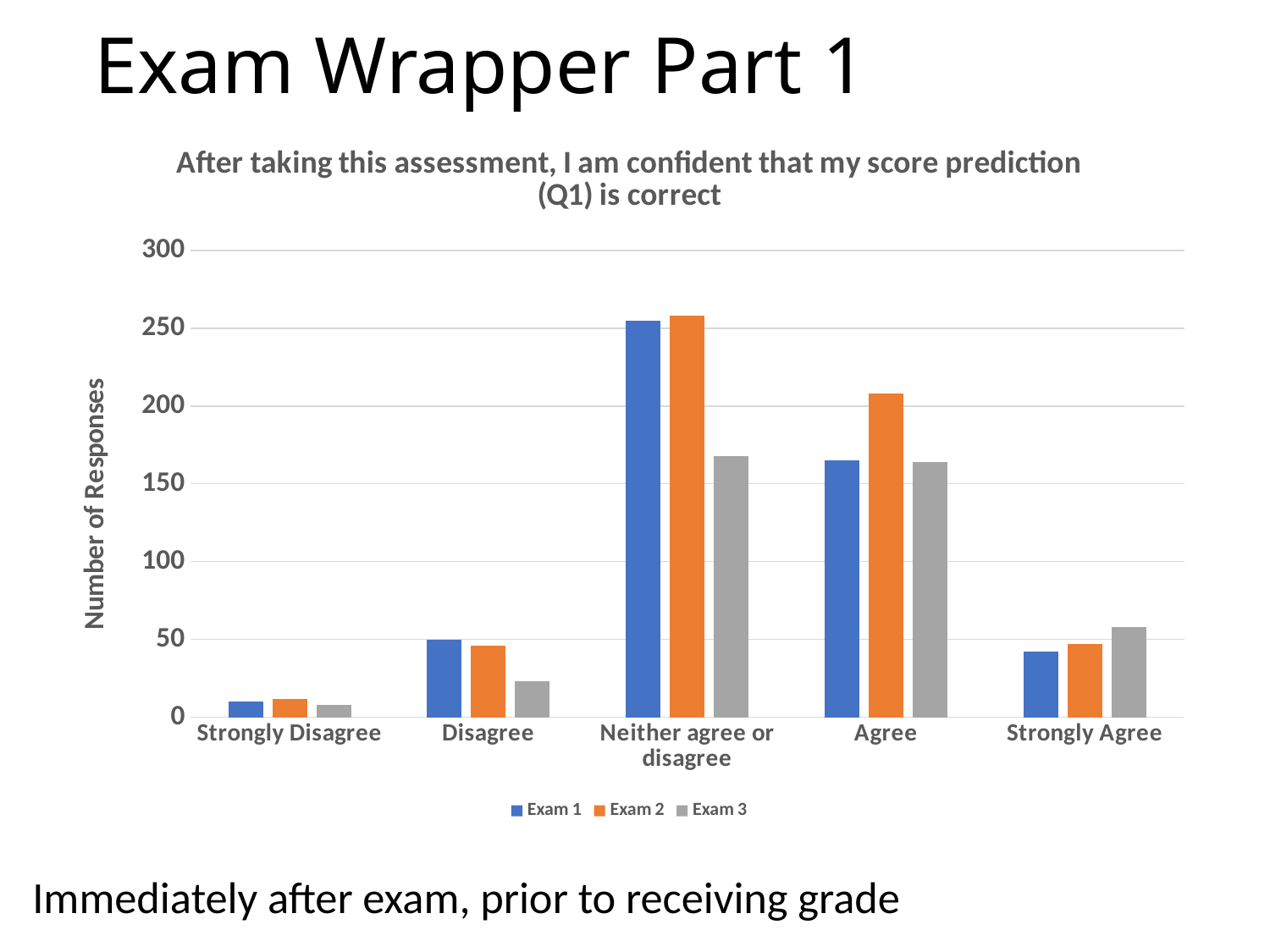
Which exam has the highest number of responses for Agree? Exam 2 Is the value for Exam 1 in the Disagree category greater or less than 100? less For Agree, which is larger: Exam 2 or Exam 3? Exam 2 How many response categories are shown on the x axis? 5 Is the value for Exam 2 in the Agree category greater or less than 200? greater How many series does the legend list? 3 Which response category has the highest number of responses for Exam 1? Neither agree or disagree What is the label of the y axis? Number of Responses Which exam has the highest number of responses for Strongly Agree? Exam 3 Which response category has the lowest number of responses for Exam 3? Strongly Disagree What kind of chart is shown on the slide? bar chart For Neither agree or disagree, which is larger: Exam 1 or Exam 3? Exam 1